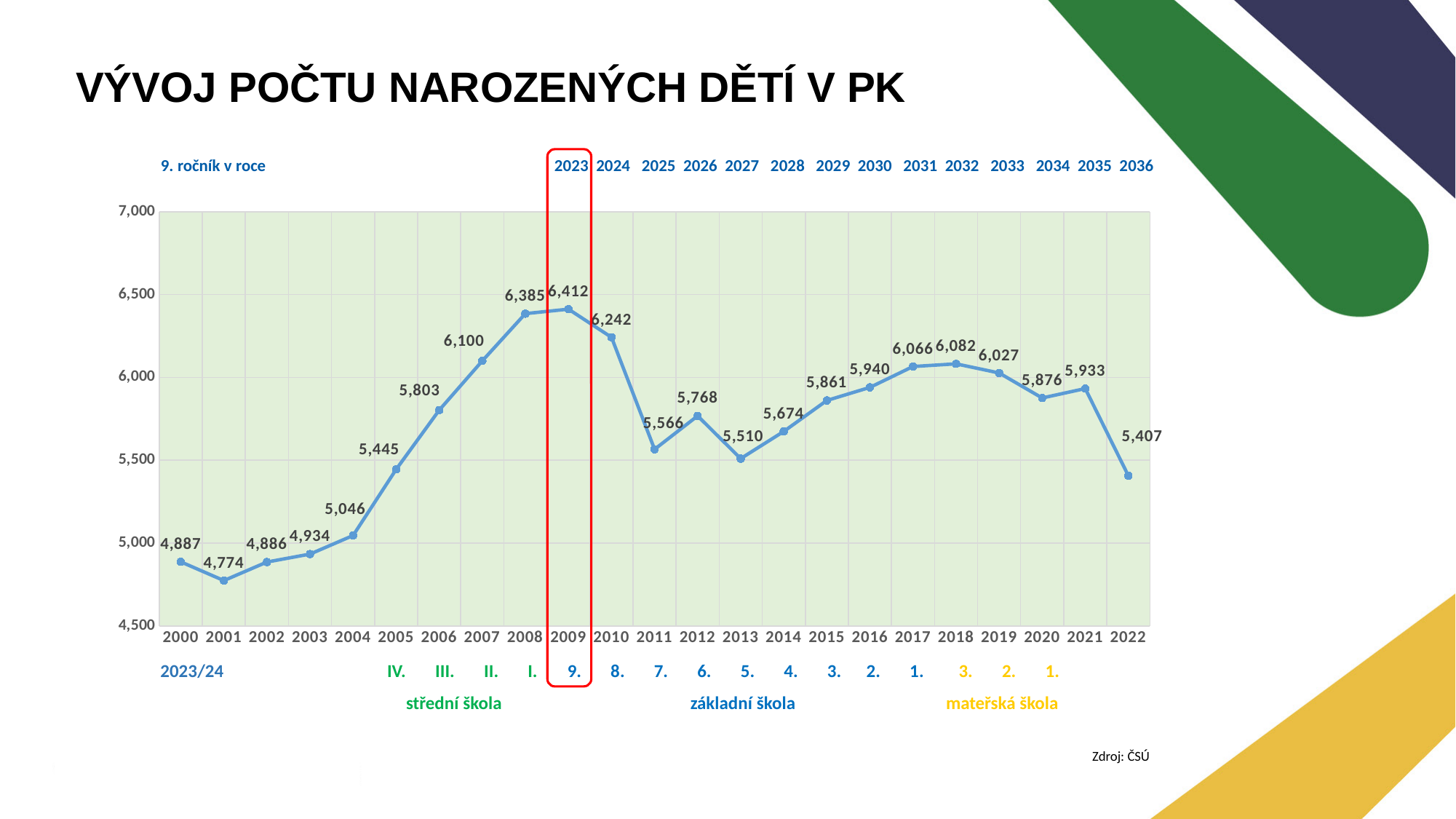
What type of chart is shown on the slide? line chart Which year has the larger value, 2017 or 2018? 2018 What is the difference between the values for 2009 and 2001? 1,638 How many years are plotted on the x axis? 23 Is the value for 2013 greater or less than 6,000? less What is the value for 2001? 4,774 Which year has the highest value? 2009 Which year has the lowest value? 2001 What is the difference between the values for 2021 and 2022? 526 What is the number of children born in 2009? 6,412 What is the value for 2022? 5,407 Do the values rise or fall from 2000 to 2009? rise